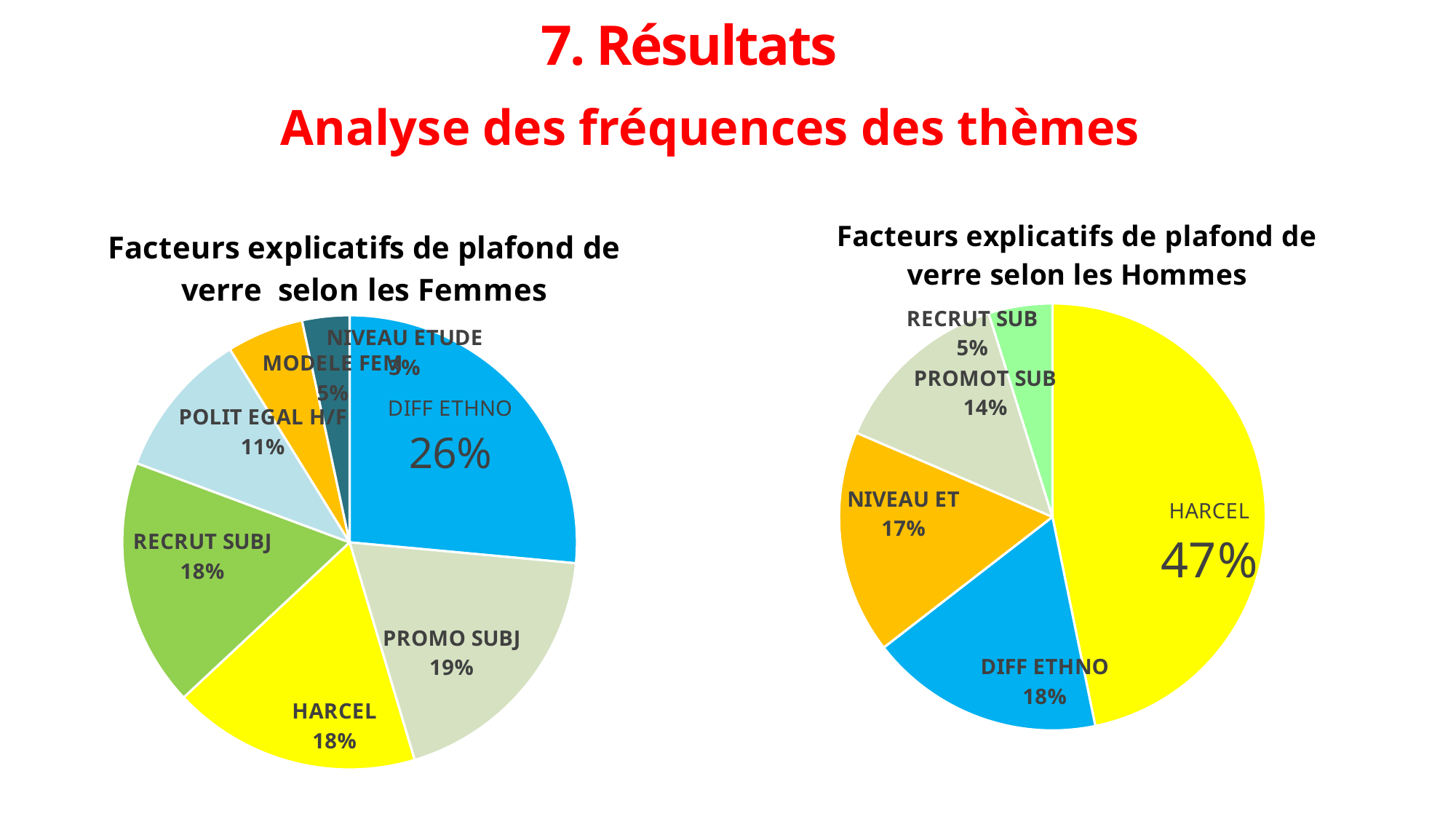
In the chart 'Facteurs explicatifs de plafond de verre selon les Femmes', what share does POLIT EGAL H/F have? 11% In the chart 'Facteurs explicatifs de plafond de verre selon les Hommes', what share does HARCEL have? 47% In the chart 'Facteurs explicatifs de plafond de verre selon les Femmes', what is the difference between the shares of DIFF ETHNO and HARCEL? 8% In the chart 'Facteurs explicatifs de plafond de verre selon les Hommes', which is larger, DIFF ETHNO or PROMOT SUB? DIFF ETHNO In the chart 'Facteurs explicatifs de plafond de verre selon les Femmes', what share does PROMO SUBJ have? 19% In the chart 'Facteurs explicatifs de plafond de verre selon les Femmes', which factor has the largest share? DIFF ETHNO In the chart 'Facteurs explicatifs de plafond de verre selon les Hommes', how many slices does the pie have? 5 In the chart 'Facteurs explicatifs de plafond de verre selon les Hommes', what share does NIVEAU ET have? 17% In the chart 'Facteurs explicatifs de plafond de verre selon les Femmes', how many slices does the pie have? 7 In the chart 'Facteurs explicatifs de plafond de verre selon les Femmes', what share does DIFF ETHNO have? 26% In the chart 'Facteurs explicatifs de plafond de verre selon les Hommes', which factor has the smallest share? RECRUT SUB What type of chart is used for 'Facteurs explicatifs de plafond de verre selon les Hommes'? Pie chart